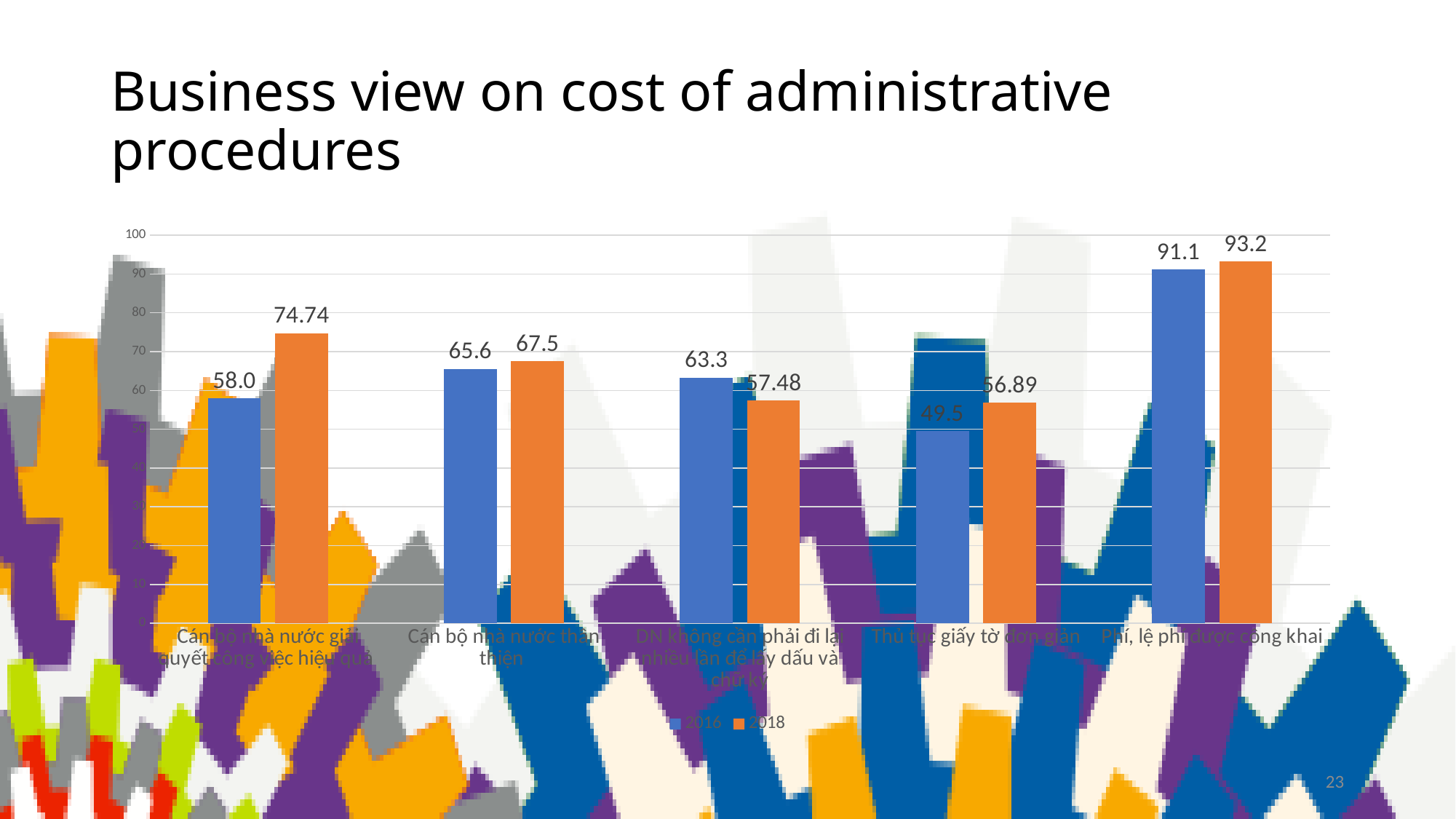
What kind of chart is shown on the slide? bar chart Which category has the highest 2016 value? Phí, lệ phí được công khai What is the difference between the 2018 and 2016 values for "Cán bộ nhà nước giải quyết công việc hiệu quả"? 16.74 How many categories are shown on the x axis? 5 What is the 2018 value for "Cán bộ nhà nước thân thiện"? 67.5 What is the 2016 value for "Thủ tục giấy tờ đơn giản"? 49.5 What is the 2018 value for "Phí, lệ phí được công khai"? 93.2 Which series is shown in orange? 2018 Is the 2016 value for "Thủ tục giấy tờ đơn giản" greater or less than 50? less For "DN không cần phải đi lại nhiều lần để lấy dấu và chữ ký", which year has the larger value, 2016 or 2018? 2016 How many series does the legend list? 2 Which category has the lowest 2018 value? Thủ tục giấy tờ đơn giản